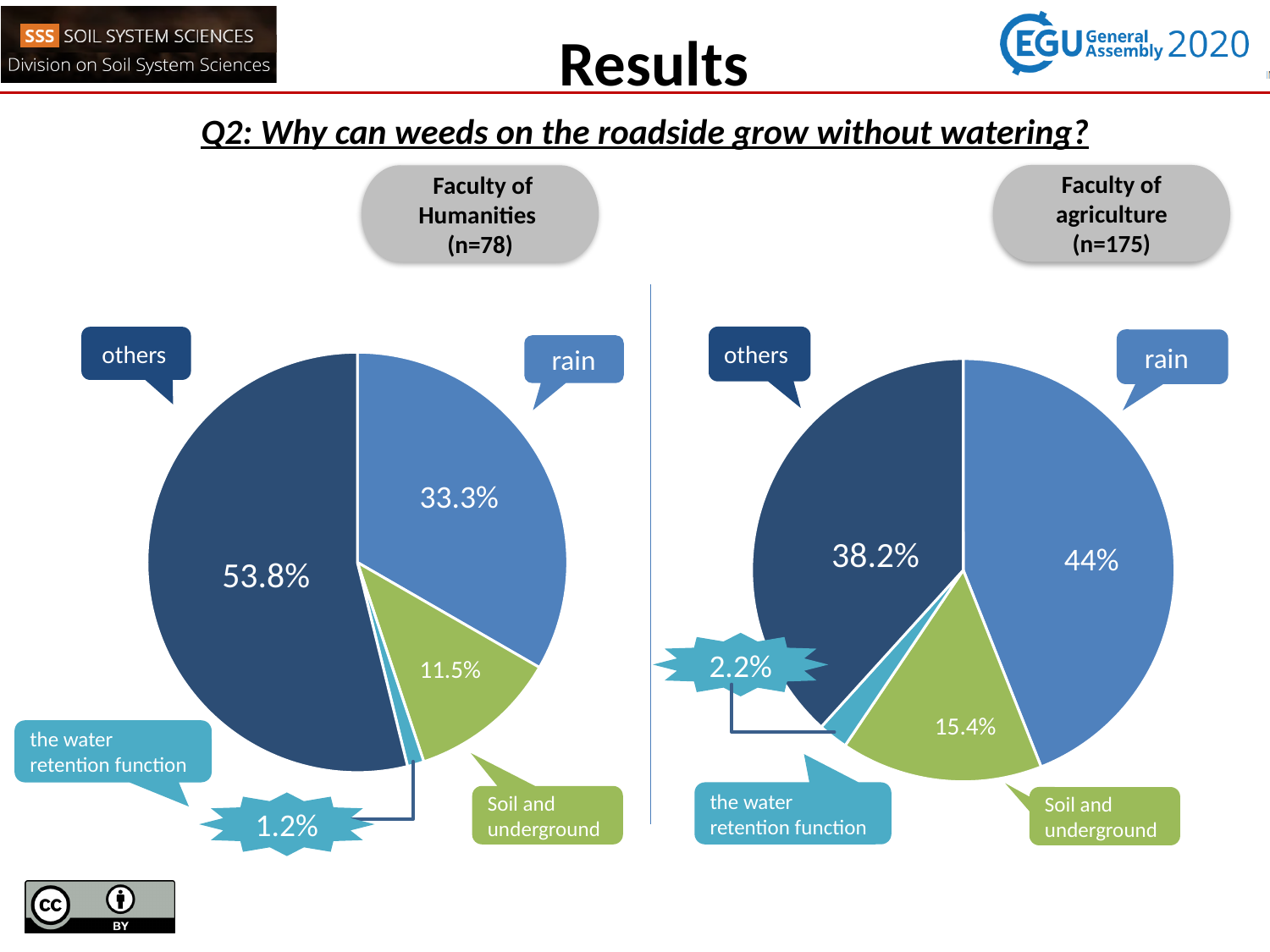
In the Faculty of agriculture chart, what percentage of respondents answered "rain"? 44% In the Faculty of Humanities chart, which answer has the smallest share? the water retention function In the Faculty of Humanities chart, what percentage of respondents answered "rain"? 33.3% In the Faculty of agriculture chart, what is the difference between the "rain" share and the "others" share? 5.8% In the Faculty of agriculture chart, which answer has the largest share? rain What type of chart is used for the Faculty of Humanities results? Pie chart In the Faculty of Humanities chart, what is the difference between the "others" share and the "rain" share? 20.5% In the Faculty of agriculture chart, what percentage of respondents answered "Soil and underground"? 15.4% In the Faculty of Humanities chart, what percentage of respondents answered "the water retention function"? 1.2% Which chart shows a larger share for "Soil and underground", Faculty of Humanities or Faculty of agriculture? Faculty of agriculture In the Faculty of Humanities chart, what percentage of respondents answered "others"? 53.8% How many slices does the Faculty of agriculture pie chart have? 4